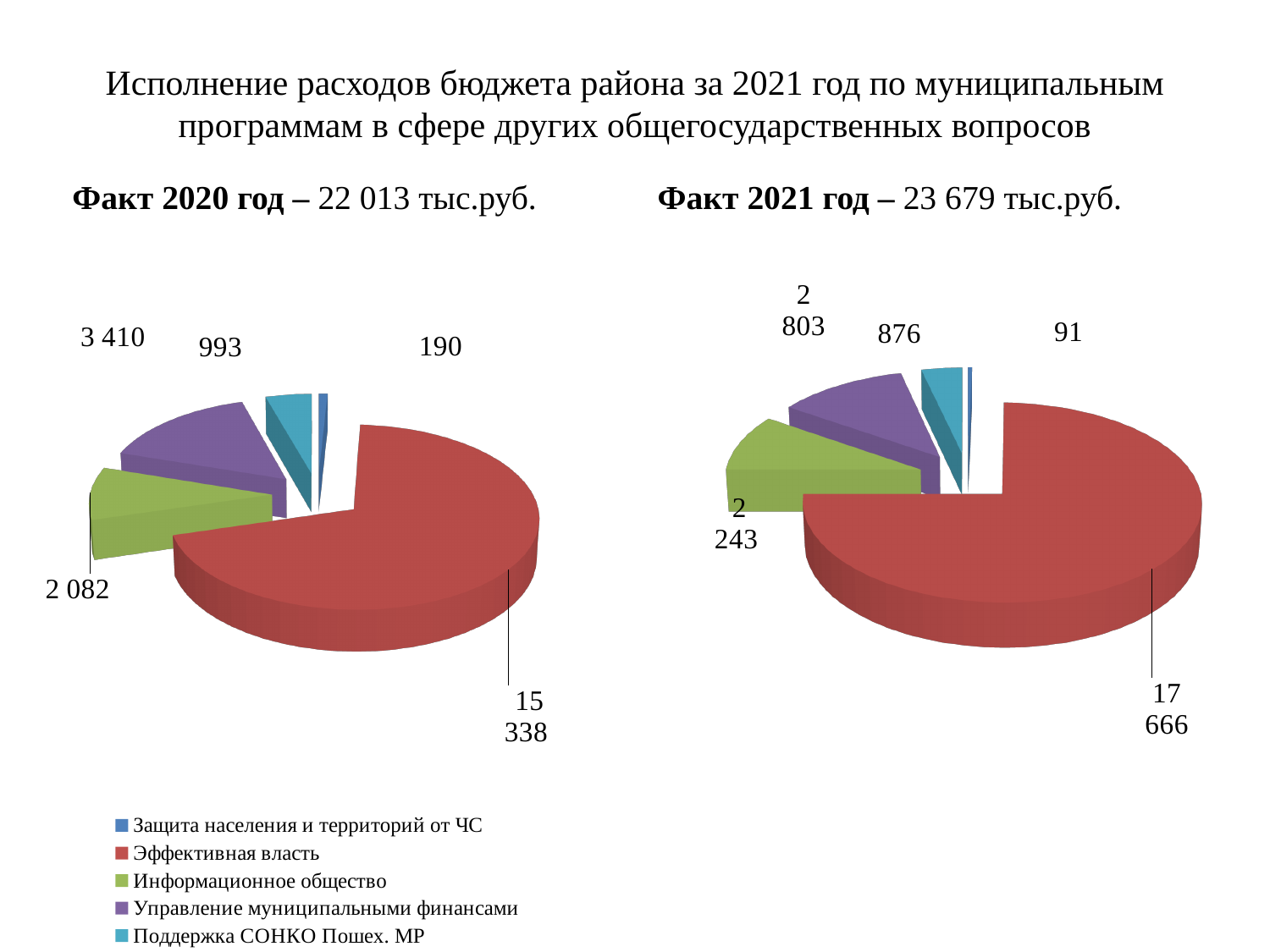
In the Факт 2020 год chart, which category has the largest slice? Эффективная власть In the Факт 2021 год chart, what is the value for Информационное общество? 2 243 In the Факт 2021 год chart, which category has the smallest slice? Защита населения и территорий от ЧС Which colour represents Информационное общество in the legend? green In the Факт 2021 год chart, which is larger: Управление муниципальными финансами or Поддержка СОНКО Пошех. МР? Управление муниципальными финансами What kind of chart is used on the left (Факт 2020 год) side of the slide? pie chart In the Факт 2020 год chart, what is the value for Эффективная власть? 15 338 What is the total of the Факт 2020 год chart as stated on the slide? 22 013 тыс.руб. In the Факт 2021 год chart, what is the value for Защита населения и территорий от ЧС? 91 How many slices does the Факт 2021 год pie chart have? 5 How many categories does the legend list? 5 In the Факт 2020 год chart, what is the difference between Управление муниципальными финансами and Информационное общество? 1 328